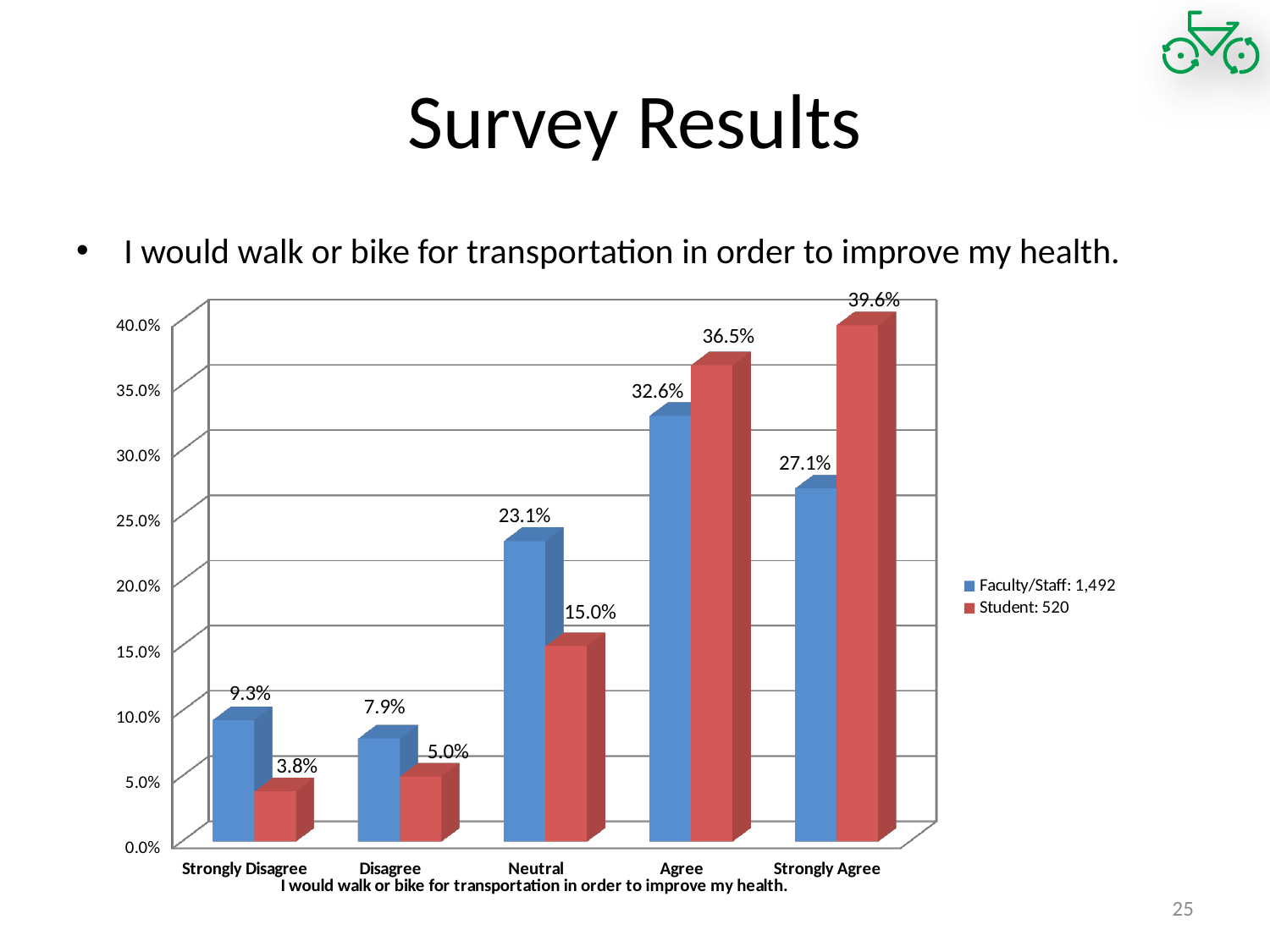
What percentage of Students responded Strongly Disagree? 3.8% Which colour represents the Student series in the chart? Red What is the difference between the Student and Faculty/Staff values for Strongly Agree? 12.5% Which is larger for Neutral: the Faculty/Staff value or the Student value? Faculty/Staff How many response categories are shown on the x axis? 5 Which response category has the lowest value for Students? Strongly Disagree What percentage of Students responded Strongly Agree? 39.6% Which response category has the highest value for Faculty/Staff? Agree Is the Faculty/Staff value for Agree greater or less than 30.0%? greater How many series does the legend list? 2 What percentage of Faculty/Staff responded Neutral? 23.1% What kind of chart is shown on the slide? Bar chart